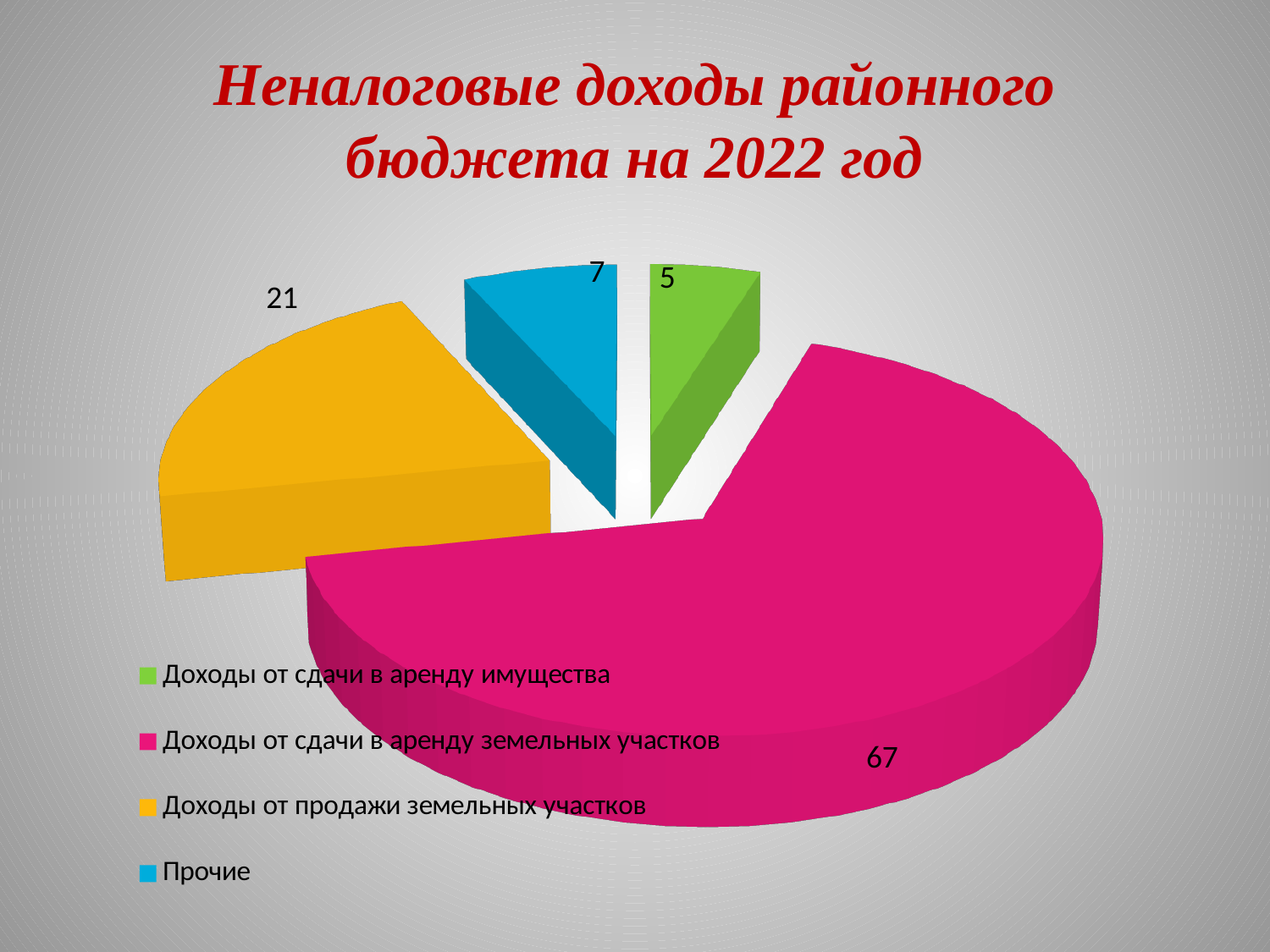
What is the title of the chart on the slide? Неналоговые доходы районного бюджета на 2022 год What is the value for "Доходы от сдачи в аренду земельных участков"? 67 How many slices does the pie chart have? 4 What is the value for "Доходы от продажи земельных участков"? 21 What colour is the slice for "Доходы от продажи земельных участков"? Yellow Which is larger: the value for "Прочие" or the value for "Доходы от сдачи в аренду имущества"? Прочие What is the value for "Прочие"? 7 What is the difference between the values for "Доходы от сдачи в аренду земельных участков" and "Доходы от продажи земельных участков"? 46 Which category has the largest slice of the pie? Доходы от сдачи в аренду земельных участков What is the value for "Доходы от сдачи в аренду имущества"? 5 Which category has the smallest slice of the pie? Доходы от сдачи в аренду имущества What type of chart is shown on the slide? Pie chart